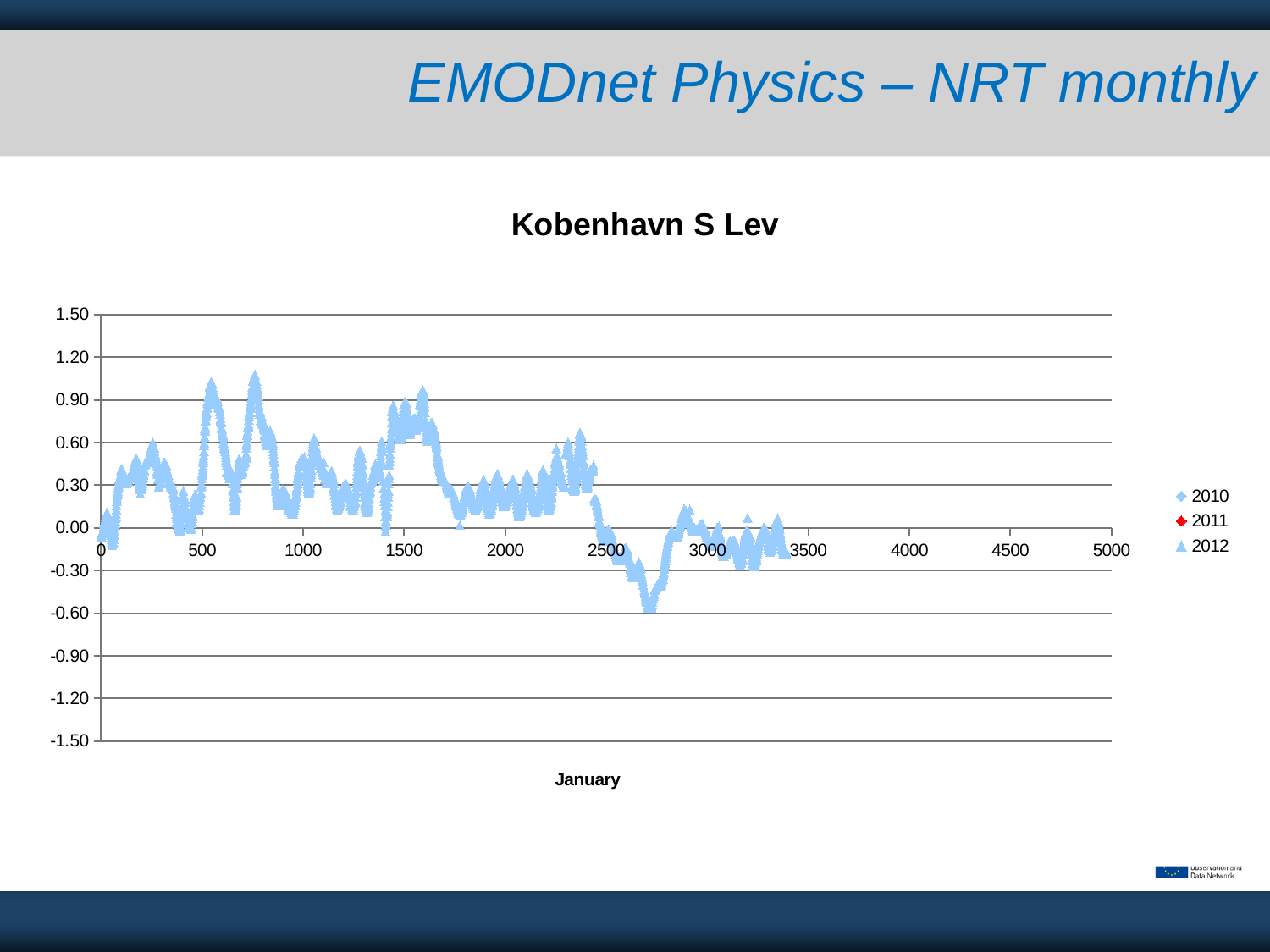
What is the maximum value shown on the chart's x axis? 5000 Is the lowest plotted value in the chart greater or less than -0.30? less Is the lowest plotted value in the chart greater or less than -0.90? greater Is the highest plotted value in the chart greater or less than 0.90? greater Which series are listed in the chart's legend? 2010, 2011, 2012 What kind of chart is shown on the slide? scatter chart Do the plotted values generally rise or fall from the left of the x axis to the right? fall What is the maximum value shown on the chart's y axis? 1.50 How many series does the chart's legend list? 3 What is the title of the chart? Kobenhavn S Lev